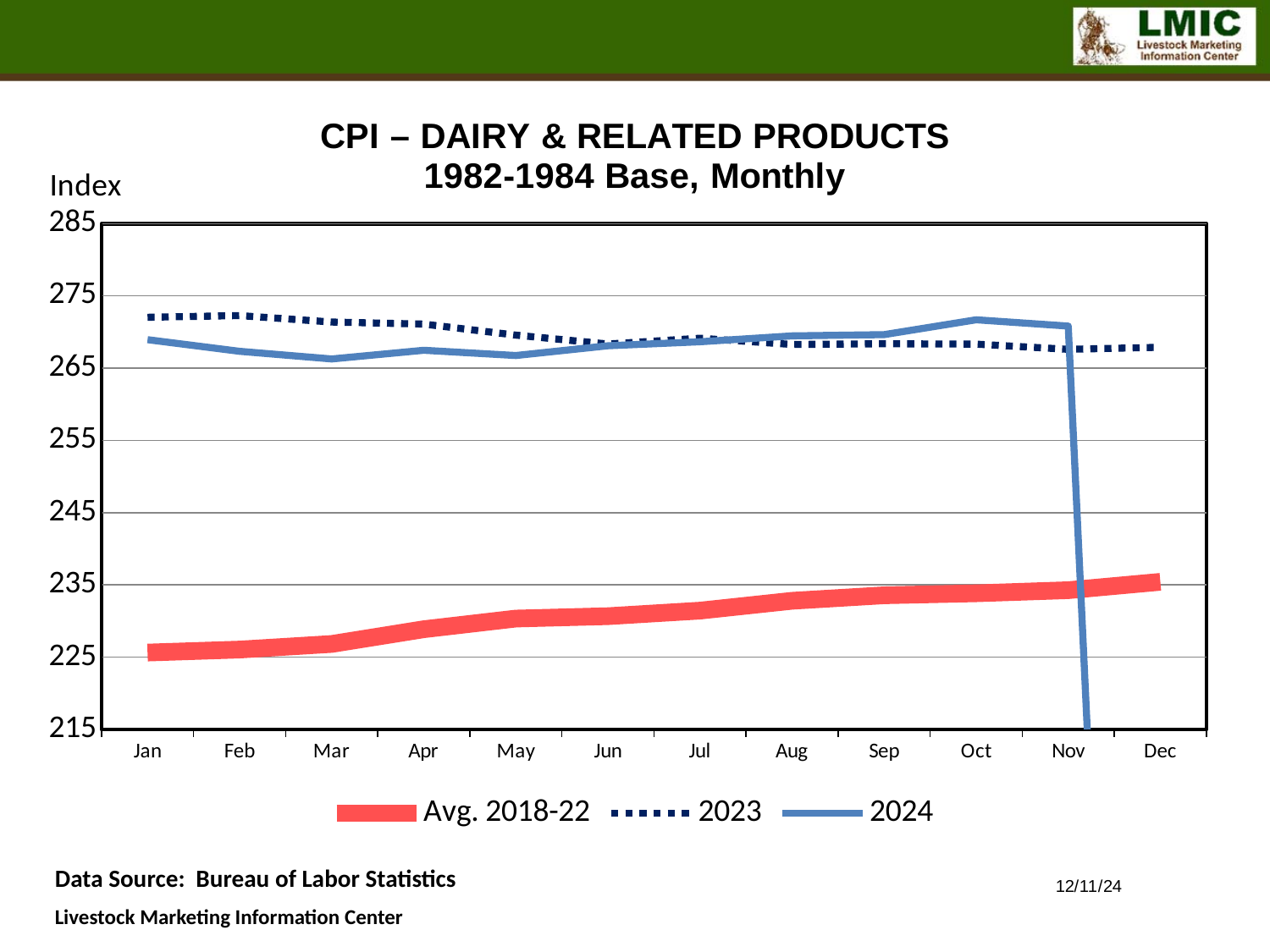
What kind of chart is shown on the slide? line chart Is the 2023 value for Jan greater or less than 275? less In Oct, which series has the higher value, 2023 or 2024? 2024 How many series does the legend list? 3 In which month is the Avg. 2018-22 series lowest? Jan Which series is drawn as a dotted line? 2023 Does the Avg. 2018-22 series rise or fall from Jan to Dec? rise How many months are shown along the x axis? 12 Is the Avg. 2018-22 value for Jun greater or less than 225? greater What is the title of the chart? CPI – DAIRY & RELATED PRODUCTS 1982-1984 Base, Monthly In Jan, which series has the higher value, 2023 or 2024? 2023 Is the 2024 value for Oct greater or less than 265? greater